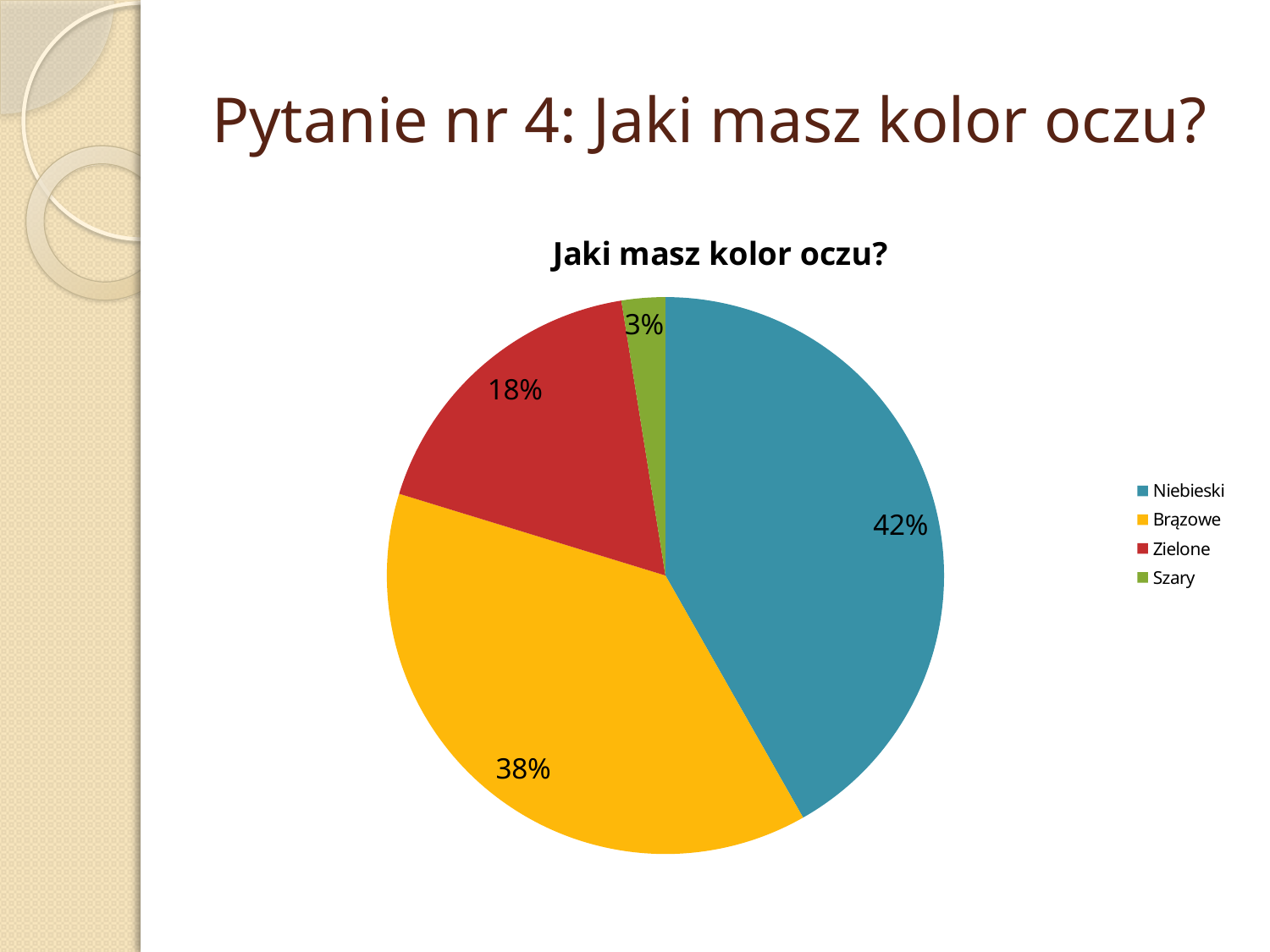
Which category has the smallest slice of the pie? Szary How many categories does the pie chart show? 4 Which is larger, the share for Brązowe or the share for Zielone? Brązowe What is the difference in percentage points between Niebieski and Brązowe? 4% What share of the pie does Brązowe have? 38% What share of the pie does Szary have? 3% What is the title of the chart? Jaki masz kolor oczu? What is the difference in percentage points between Zielone and Szary? 15% What share of the pie does Zielone have? 18% Which category has the largest slice of the pie? Niebieski What kind of chart is shown on the slide? Pie chart